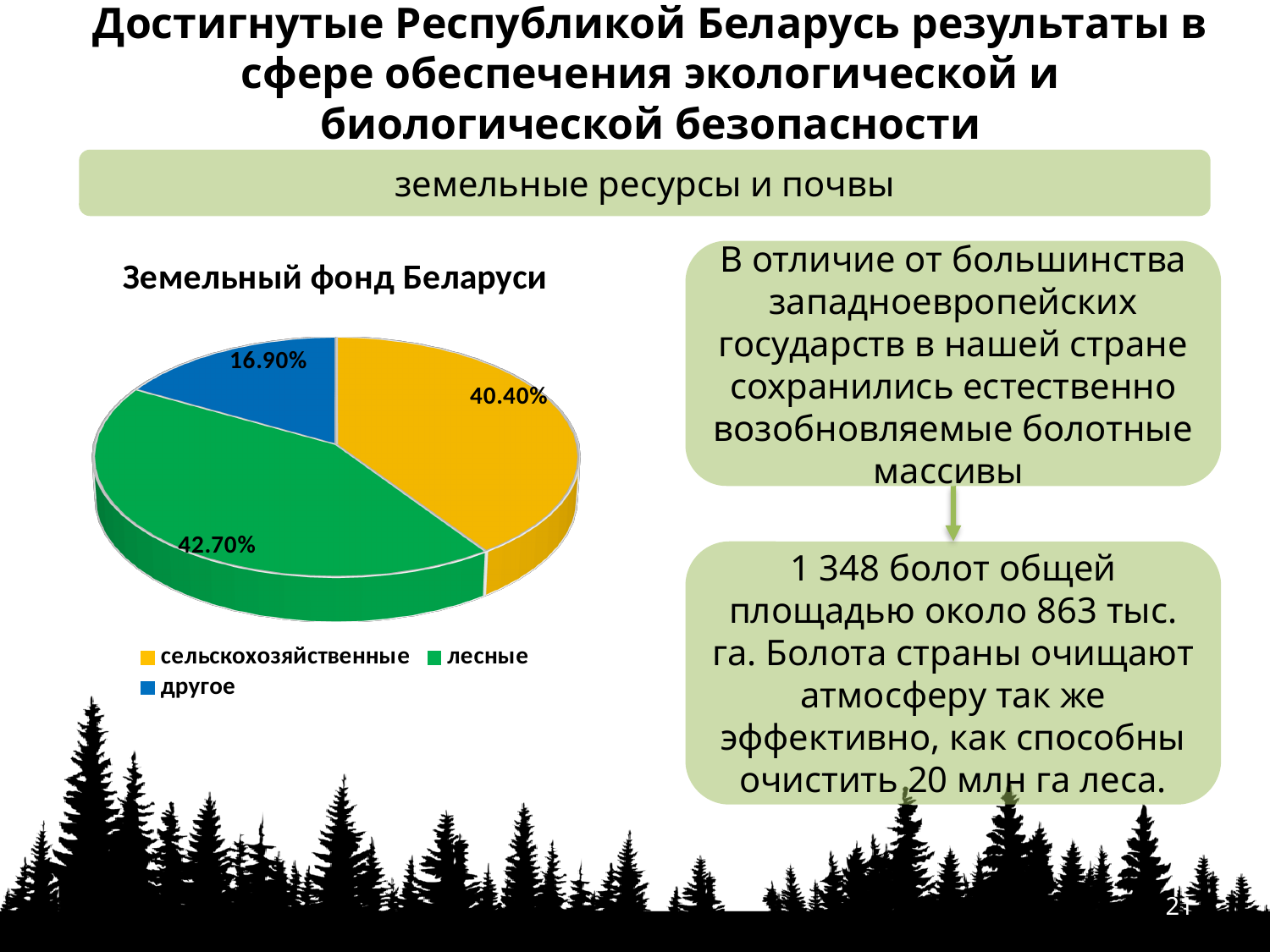
Which category has the smallest share in the pie chart? другое How many categories does the pie chart show? 3 Which is larger in the pie chart: "сельскохозяйственные" or "другое"? сельскохозяйственные What is the title of the pie chart? Земельный фонд Беларуси What type of chart is shown under the title "Земельный фонд Беларуси"? pie chart What is the difference between the shares of "сельскохозяйственные" and "другое"? 23.50% What is the difference between the shares of "лесные" and "сельскохозяйственные"? 2.30% What colour represents "лесные" in the pie chart? green What is the value for "сельскохозяйственные" in the pie chart? 40.40% What is the value for "лесные" in the pie chart? 42.70% What is the value for "другое" in the pie chart? 16.90% Which category has the largest share in the pie chart? лесные